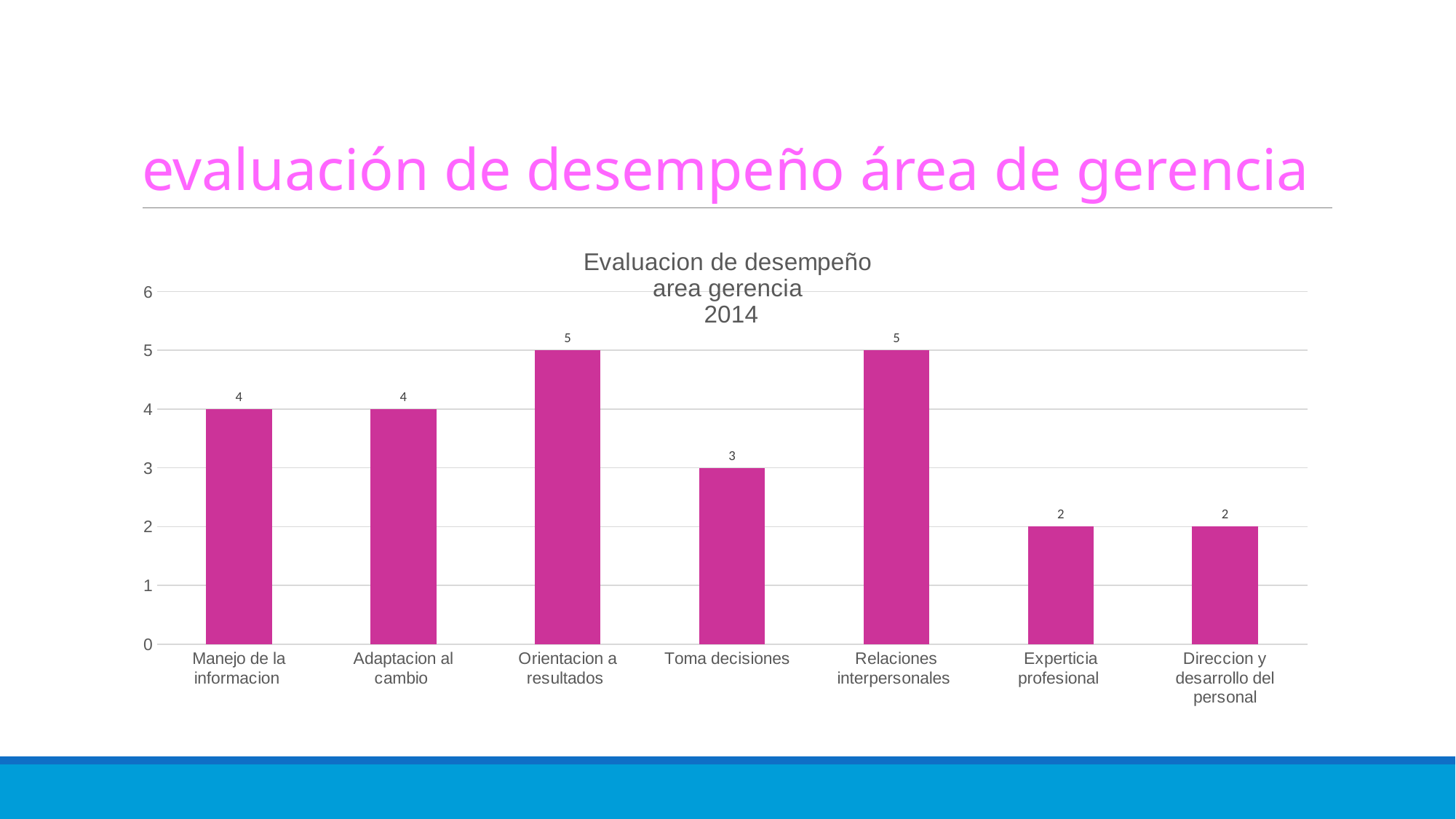
What colour are the bars in the chart? Magenta What is the value for Manejo de la informacion? 4 What is the title of the chart? Evaluacion de desempeño area gerencia 2014 What is the value for Relaciones interpersonales? 5 What is the value for Experticia profesional? 2 Which is larger, the value for Adaptacion al cambio or the value for Direccion y desarrollo del personal? Adaptacion al cambio Which categories have the lowest value? Experticia profesional and Direccion y desarrollo del personal Which categories have the highest value? Orientacion a resultados and Relaciones interpersonales How many categories are shown on the x axis? 7 What is the difference between the values for Orientacion a resultados and Toma decisiones? 2 What is the value for Toma decisiones? 3 What kind of chart is shown on the slide? Bar chart